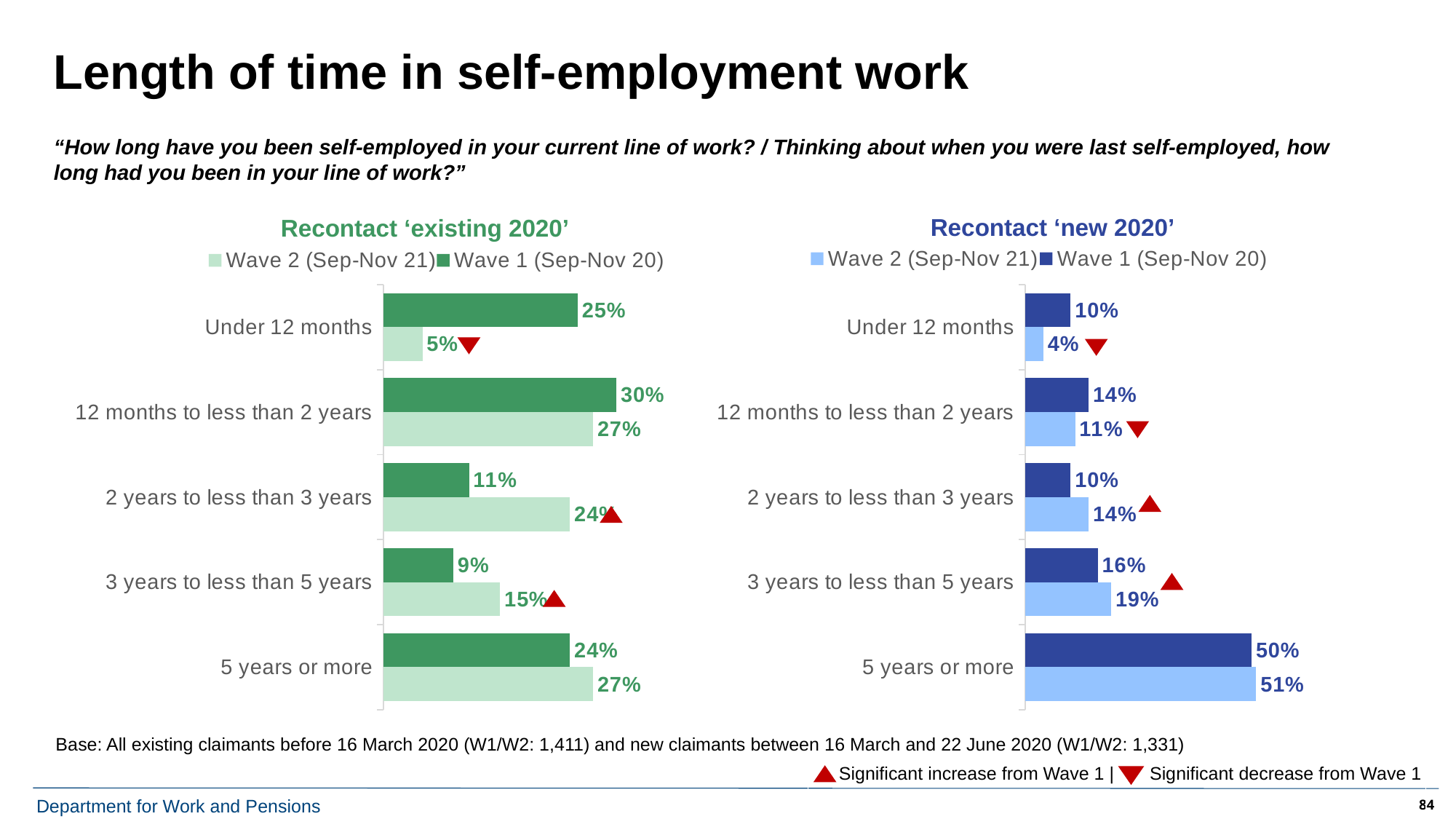
In the 'Recontact ‘new 2020’' chart, what is the difference between the Wave 2 and Wave 1 values for '3 years to less than 5 years'? 3 percentage points What type of chart is the 'Recontact ‘existing 2020’' chart? Bar chart How many series does the legend of the 'Recontact ‘existing 2020’' chart list? 2 In the 'Recontact ‘new 2020’' chart, which is larger for '12 months to less than 2 years': Wave 1 or Wave 2? Wave 1 (Sep-Nov 20) In the 'Recontact ‘existing 2020’' chart, what is the difference between the Wave 1 and Wave 2 values for 'Under 12 months'? 20 percentage points How many categories are shown in the 'Recontact ‘new 2020’' chart? 5 In the 'Recontact ‘existing 2020’' chart, which category has the highest Wave 2 (Sep-Nov 21) value? 12 months to less than 2 years and 5 years or more (both 27%) In the 'Recontact ‘existing 2020’' chart, which is larger for '2 years to less than 3 years': Wave 1 or Wave 2? Wave 2 (Sep-Nov 21) In the 'Recontact ‘new 2020’' chart, what is the Wave 1 (Sep-Nov 20) value for '5 years or more'? 50% In the 'Recontact ‘new 2020’' chart, what is the Wave 2 (Sep-Nov 21) value for '5 years or more'? 51% In the 'Recontact ‘existing 2020’' chart, what is the Wave 1 (Sep-Nov 20) value for 'Under 12 months'? 25% In the 'Recontact ‘new 2020’' chart, which category has the lowest Wave 2 (Sep-Nov 21) value? Under 12 months